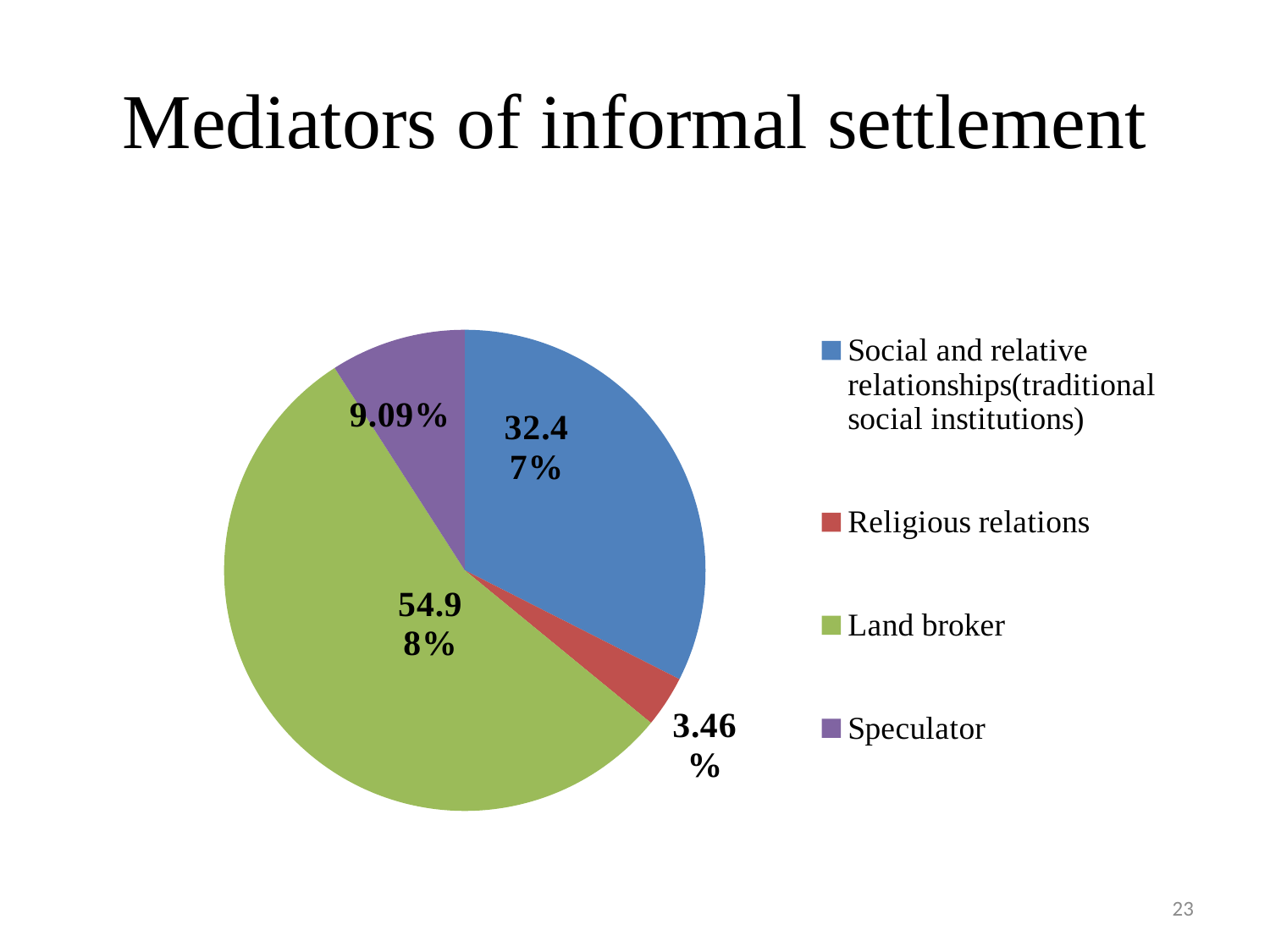
What is the share for Land broker? 54.98% What is the title of the slide containing the chart? Mediators of informal settlement Which is larger, the share for Speculator or the share for Religious relations? Speculator What is the share for Social and relative relationships (traditional social institutions)? 32.47% Which category has the largest share of the pie? Land broker What is the share for Religious relations? 3.46% What is the share for Speculator? 9.09% What type of chart is shown on the slide? pie chart How many categories does the pie chart have? 4 What is the difference between the share for Land broker and the share for Social and relative relationships? 22.51% Which category has the smallest share of the pie? Religious relations Which colour represents Land broker in the pie chart? green